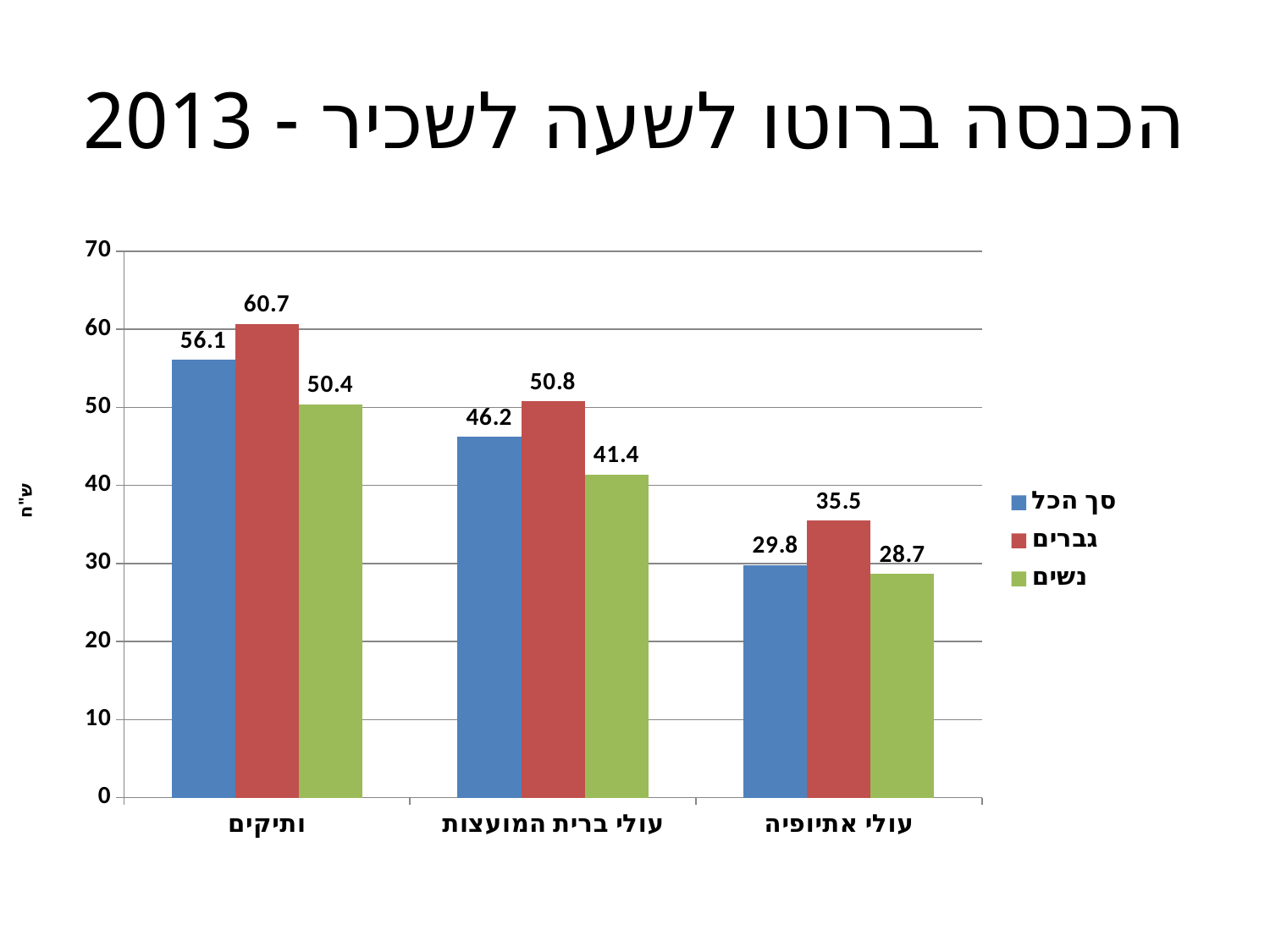
Is the value for גברים in the עולי אתיופיה category greater or less than 40? less What is the difference between the גברים and נשים values in the ותיקים category? 10.3 What is the value for סך הכל in the עולי אתיופיה category? 29.8 Which category has the highest value for גברים? ותיקים How many categories are shown on the x axis? 3 What is the value for גברים in the ותיקים category? 60.7 What kind of chart is shown on the slide? bar chart Which is larger: the סך הכל value for עולי ברית המועצות or the נשים value for ותיקים? נשים value for ותיקים What is the value for נשים in the עולי ברית המועצות category? 41.4 What is the title of the chart on the slide? הכנסה ברוטו לשעה לשכיר - 2013 How many series does the legend list? 3 Which category has the lowest value for נשים? עולי אתיופיה